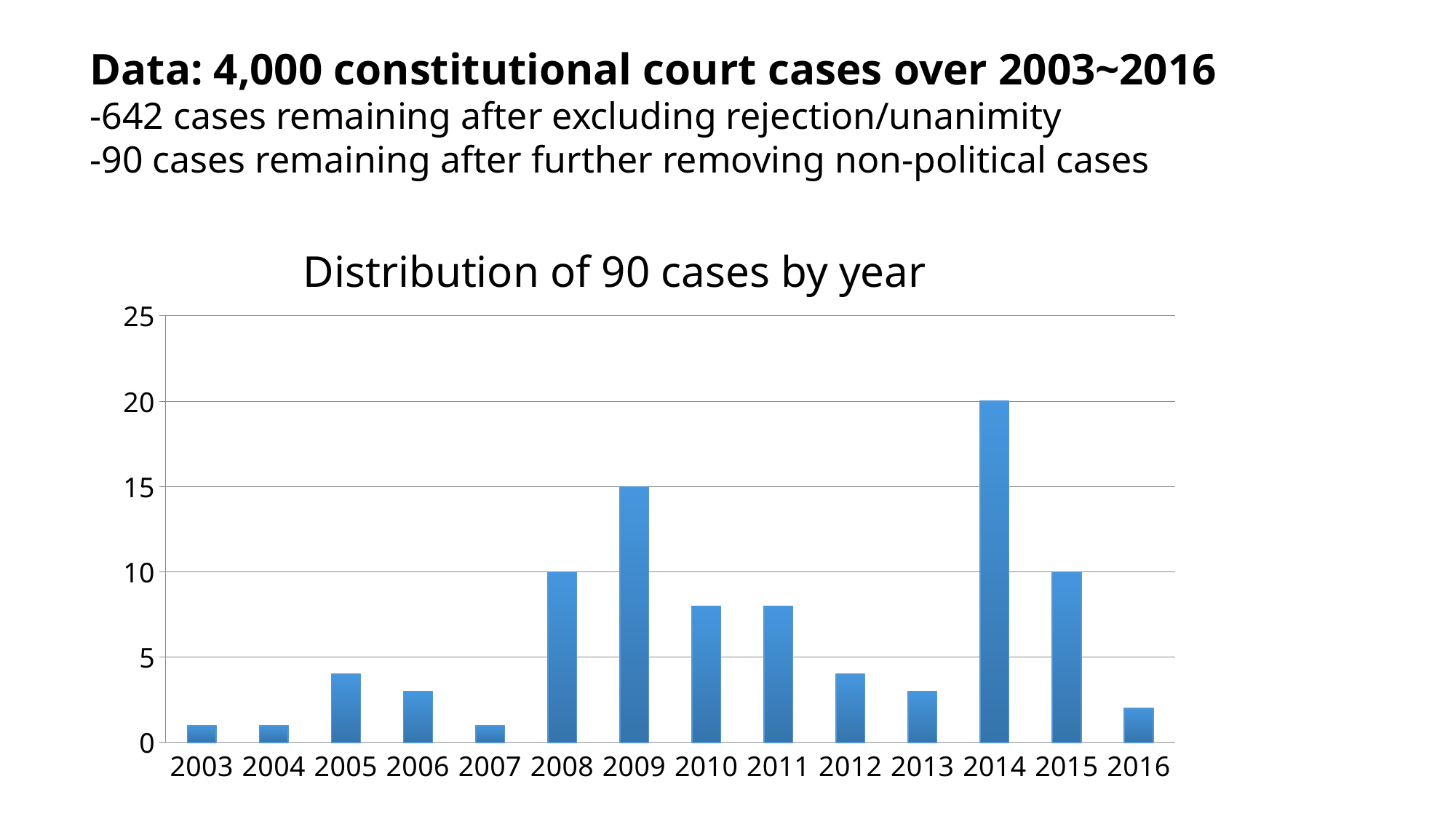
Is the value for 2010 greater or less than 10? less What is the value for 2014? 20 What is the value for 2009? 15 What is the value for 2008? 10 What is the title of the chart? Distribution of 90 cases by year What is the difference between the values for 2014 and 2009? 5 Which is larger, the value for 2009 or the value for 2015? 2009 Which year has the highest number of cases? 2014 Is the value for 2011 greater or less than 5? greater How many years are shown on the x axis of the chart? 14 What type of chart is shown on the slide? bar chart What is the value for 2015? 10